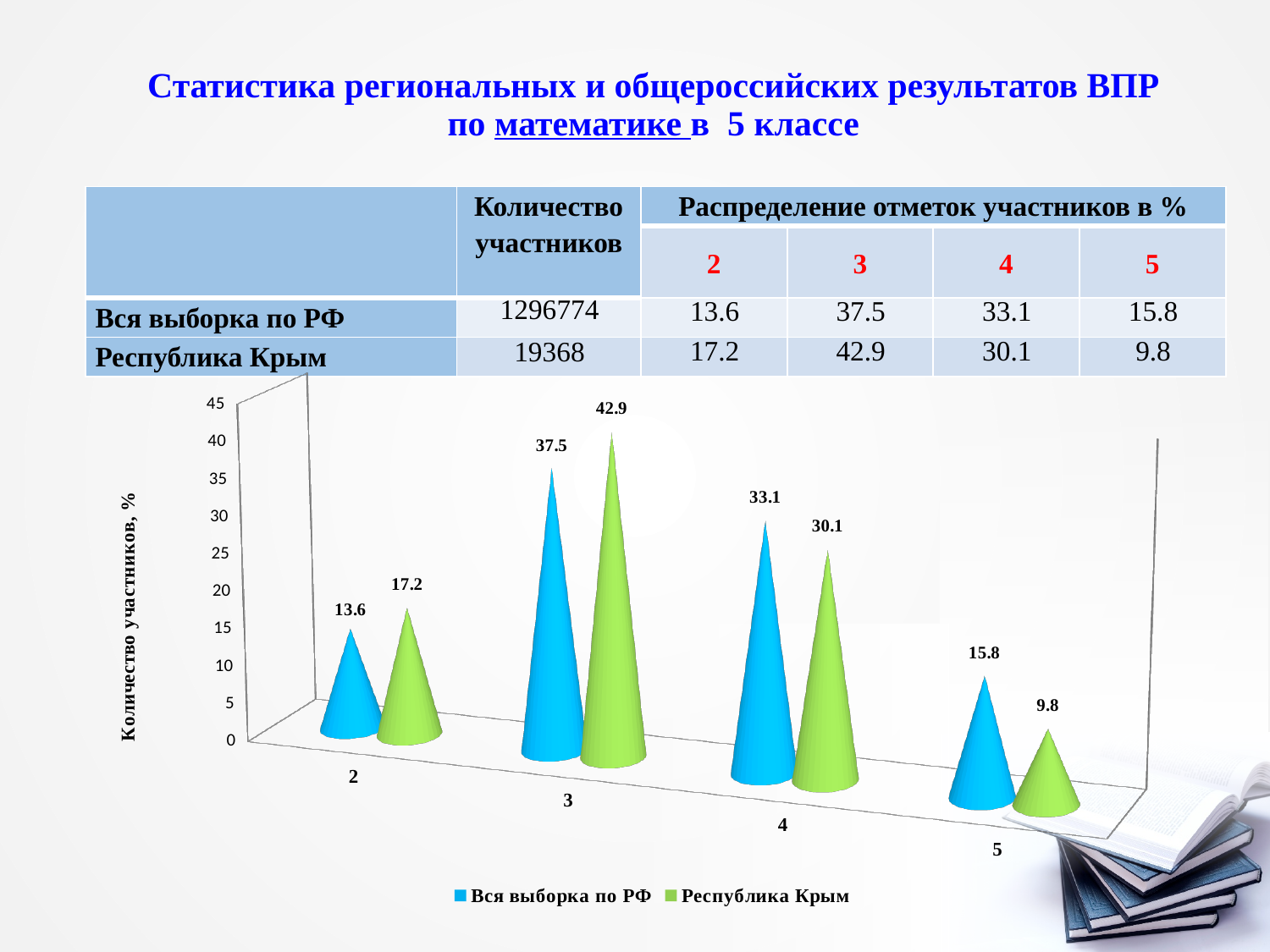
What is the difference between Республика Крым and Вся выборка по РФ at mark 2? 3.6 How many mark categories are shown on the x axis? 4 How many series does the legend list? 2 Which mark has the highest value for Вся выборка по РФ? 3 Is the value for Республика Крым at mark 3 greater or less than 40? greater What is the label of the y axis? Количество участников, % What is the value for Республика Крым at mark 3? 42.9 Which is larger at mark 4: Вся выборка по РФ or Республика Крым? Вся выборка по РФ Which mark has the lowest value for Республика Крым? 5 What is the value for Республика Крым at mark 5? 9.8 What kind of chart is shown on the slide? bar chart What is the value for Вся выборка по РФ at mark 4? 33.1